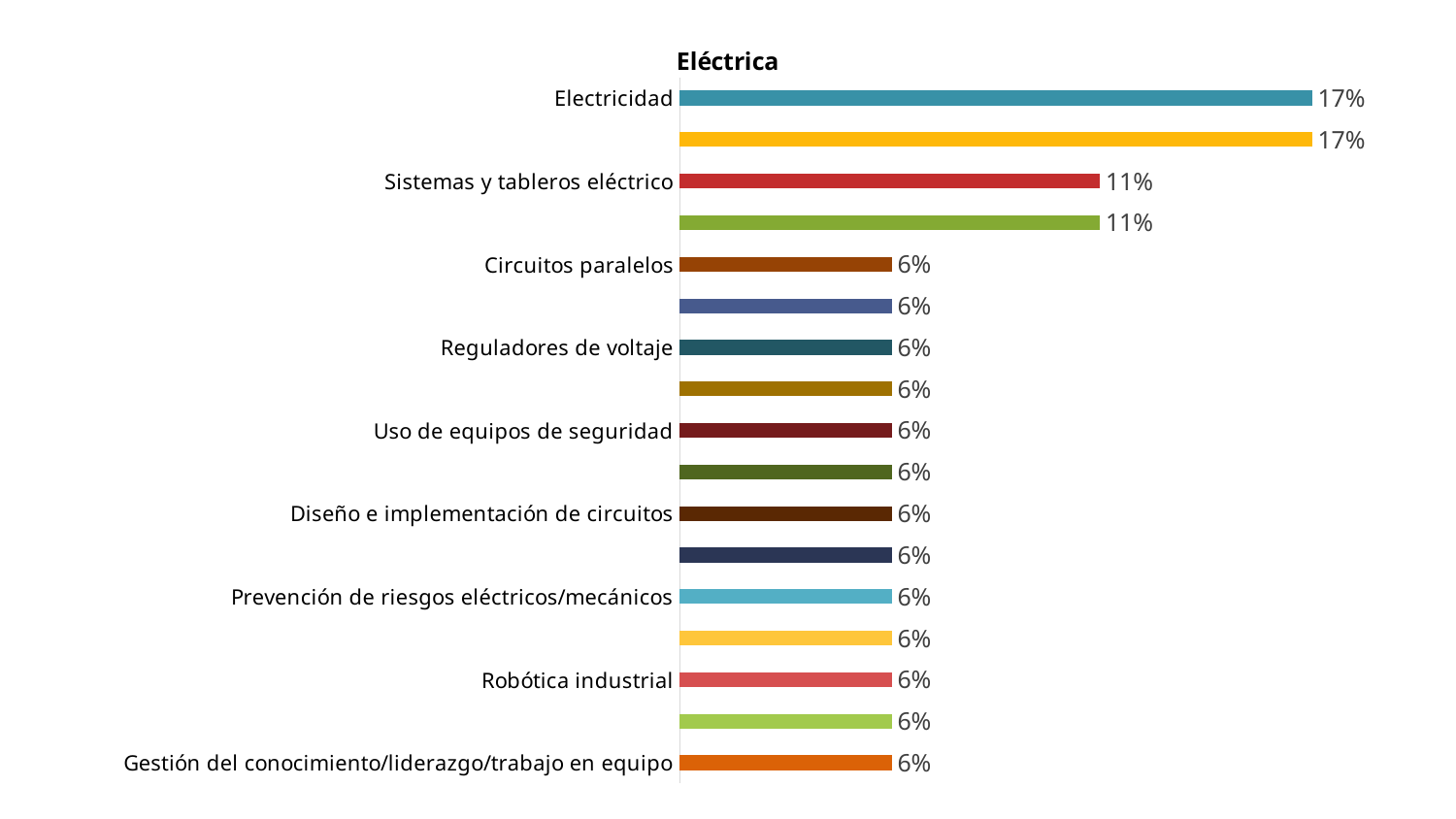
What is the value for Sistemas y tableros eléctrico? 11% Which is larger, the value for Electricidad or the value for Circuitos paralelos? Electricidad What is the title of the chart? Eléctrica How many bars are plotted on the chart? 17 What is the difference between the values for Electricidad and Sistemas y tableros eléctrico? 6 percentage points What is the value for Gestión del conocimiento/liderazgo/trabajo en equipo? 6% What is the lowest value shown on the chart? 6% What is the value for Circuitos paralelos? 6% What is the value for Robótica industrial? 6% What is the value for Electricidad? 17% What kind of chart is shown on the slide? Bar chart What is the highest value shown on the chart? 17%